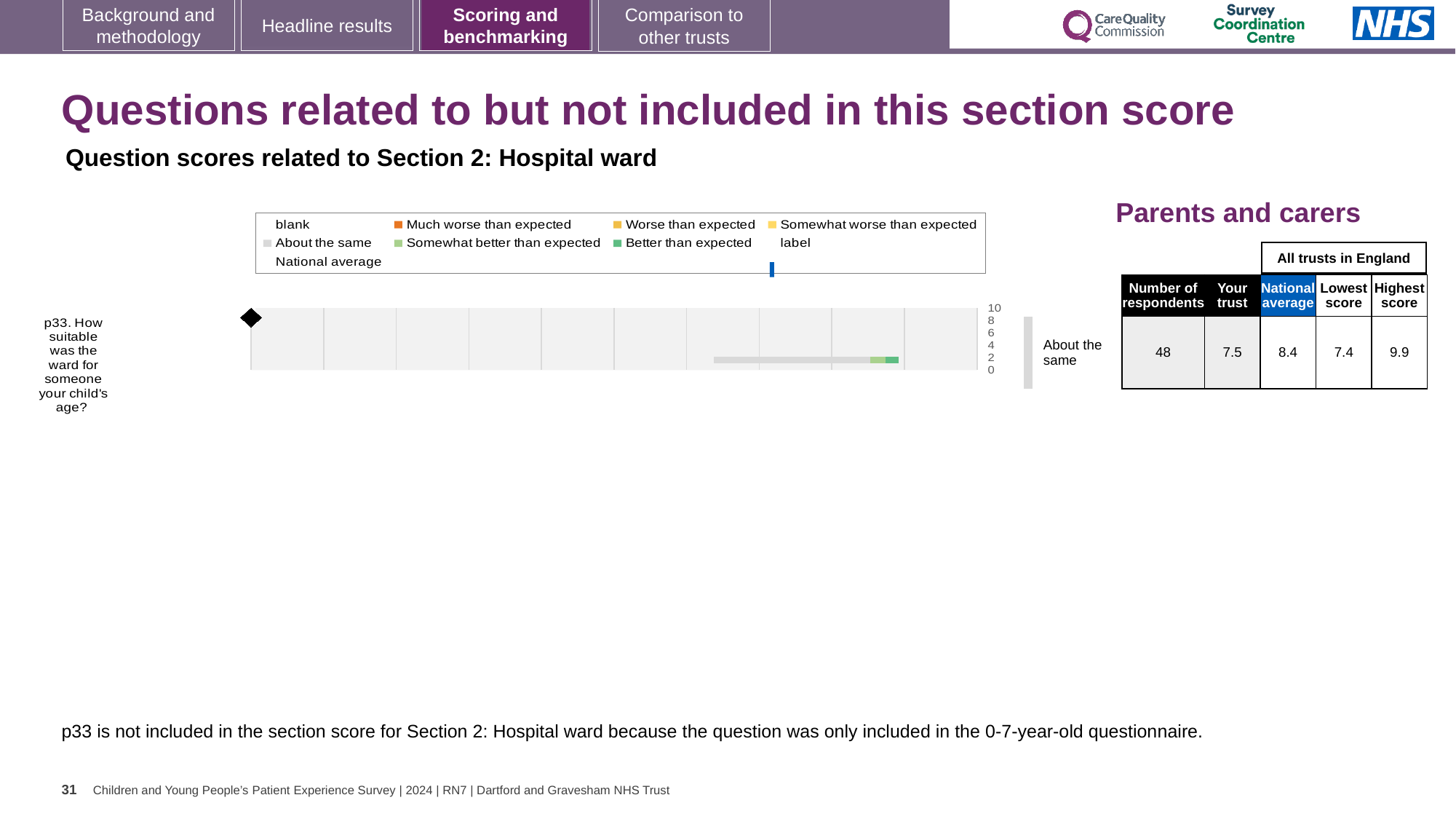
Which question is plotted in the chart? p33. How suitable was the ward for someone your child's age? What kind of chart is used to show the p33 question score? bar chart What is the national average score for p33 shown in the table beside the chart? 8.4 What is the difference between the national average (8.4) and the trust's score (7.5) for p33? 0.9 How many respondents answered p33? 48 What is the 'Your trust' score for p33 shown in the table beside the chart? 7.5 What is the highest score among all trusts in England for p33? 9.9 How many questions (categories) are plotted in the chart? 1 What is the lowest score among all trusts in England for p33? 7.4 Which is larger for p33, the trust's score or the national average? national average What benchmark category label is shown to the right of the p33 bar? About the same How many entries does the chart legend list? 9